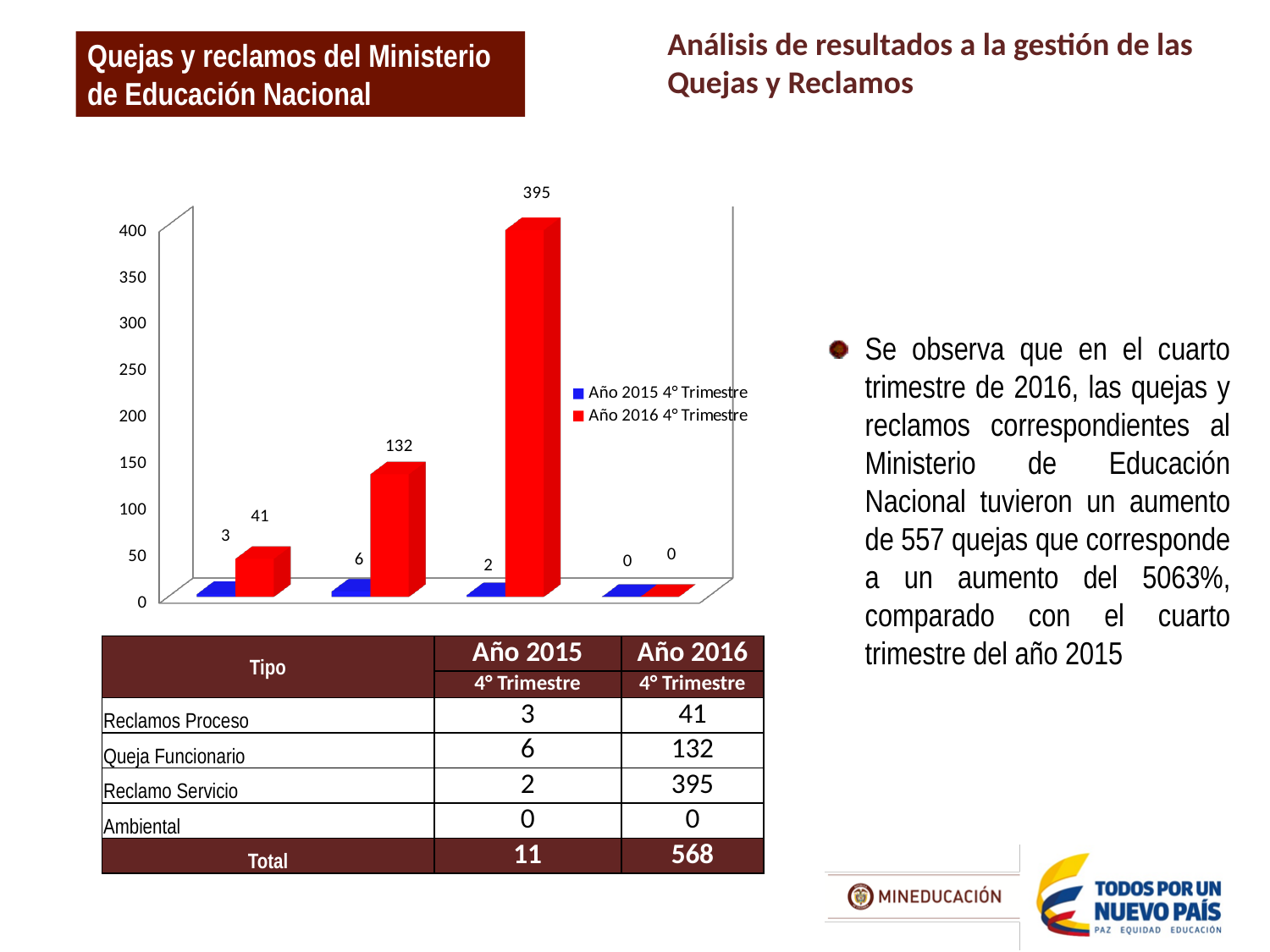
What kind of chart is shown on the slide? bar chart What colour represents the Año 2016 4° Trimestre series in the chart? red What is the difference between the Año 2016 and Año 2015 4° Trimestre values for Reclamos Proceso? 38 What is the difference between the Año 2016 4° Trimestre values for Reclamo Servicio and Queja Funcionario? 263 How many series does the chart legend list? 2 What is the value of the Año 2015 4° Trimestre bar for Queja Funcionario? 6 How many categories (groups of bars) are plotted in the chart? 4 What is the value of the Año 2016 4° Trimestre bar for Reclamo Servicio? 395 Which is larger, the Año 2016 4° Trimestre bar for Queja Funcionario or for Reclamos Proceso? Queja Funcionario Is the Año 2016 4° Trimestre value for Reclamo Servicio greater or less than 350? greater What is the value of the Año 2016 4° Trimestre bar for Ambiental? 0 Which category has the highest Año 2016 4° Trimestre bar? Reclamo Servicio